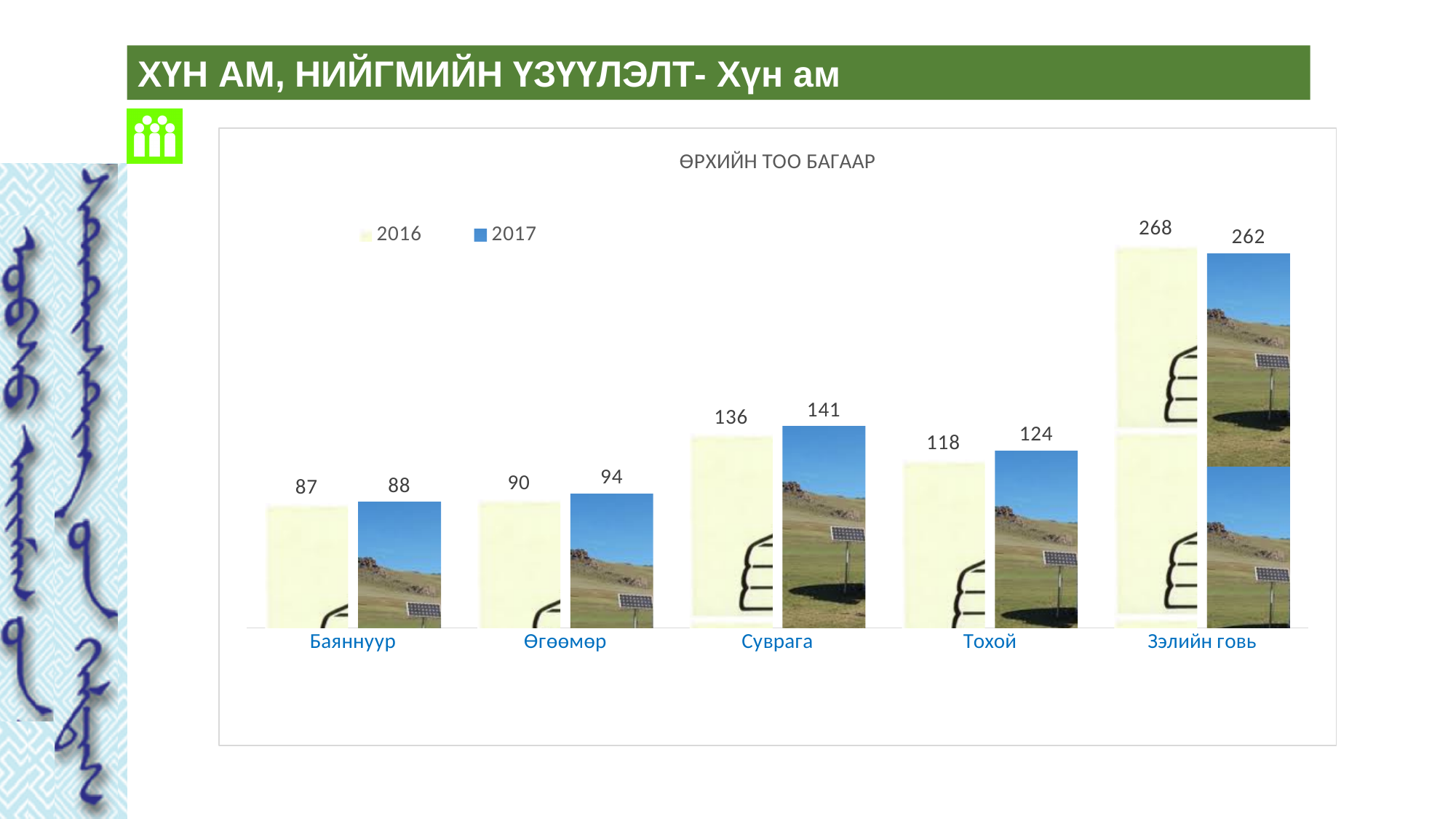
What is the difference between the 2016 and 2017 values for Зэлийн говь? 6 Which category has the lowest 2016 value? Баяннуур What is the difference between the 2017 values for Суврага and Тохой? 17 How many categories are shown on the x axis? 5 What is the 2016 value for Зэлийн говь? 268 What is the 2017 value for Суврага? 141 Which is larger, the 2016 value for Өгөөмөр or the 2017 value for Баяннуур? 2016 value for Өгөөмөр What is the title of the chart? ӨРХИЙН ТОО БАГААР Which category has the highest 2017 value? Зэлийн говь What is the 2016 value for Тохой? 118 What kind of chart is shown? bar chart How many series does the legend list? 2